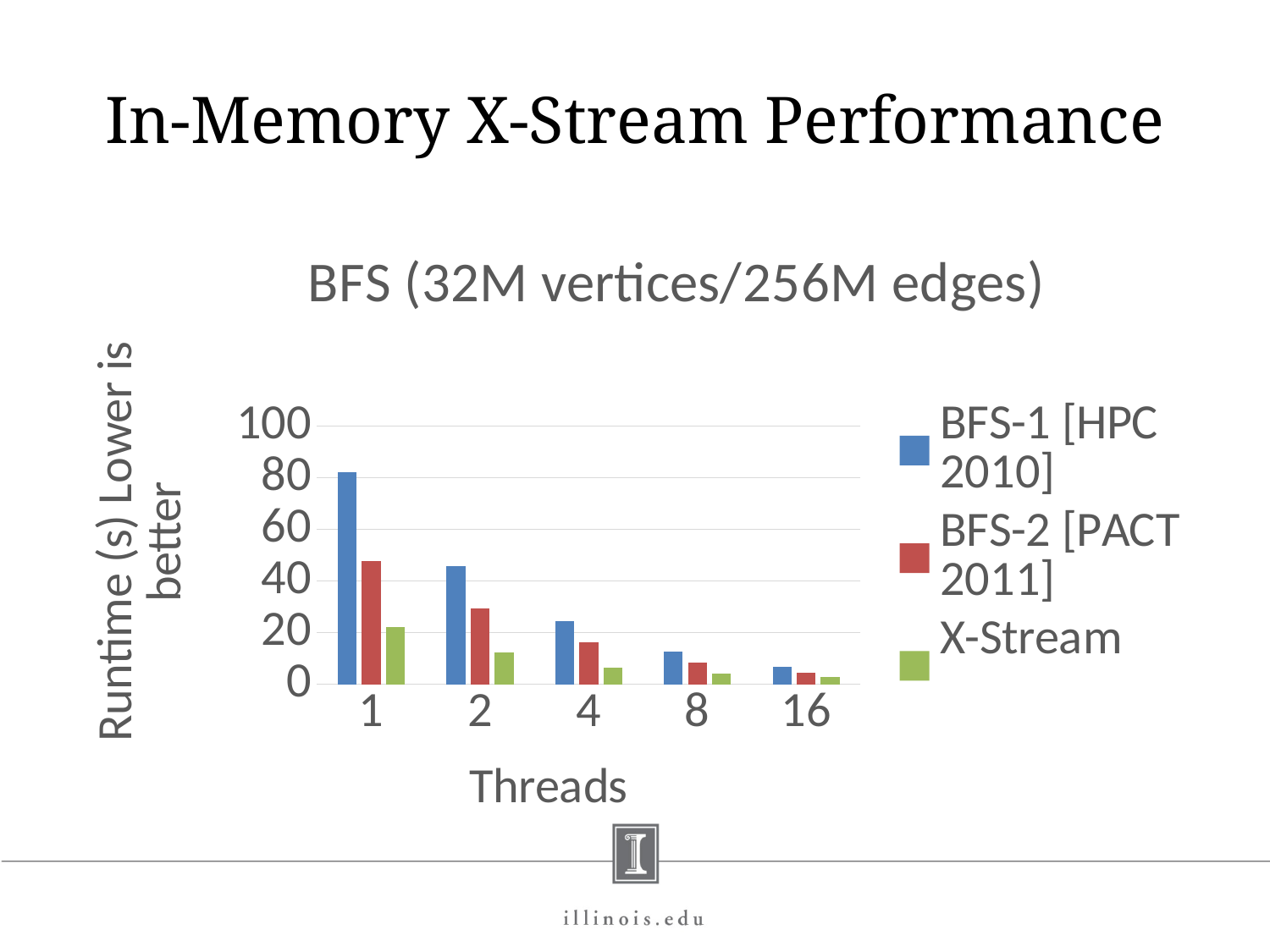
At which thread count is the BFS-1 [HPC 2010] runtime highest? 1 How does the BFS-1 [HPC 2010] runtime change as the number of threads increases? It falls Is the runtime for X-Stream at 2 threads greater or less than 20? less What is the title of the chart? BFS (32M vertices/256M edges) How many series does the legend list? 3 What is the label of the x axis? Threads Is the runtime for BFS-1 [HPC 2010] at 1 thread greater or less than 60? greater How many thread counts are shown on the x axis? 5 What kind of chart is shown on the slide? bar chart Is the runtime for BFS-2 [PACT 2011] at 1 thread greater or less than 40? greater Which series has the lowest runtime at 1 thread? X-Stream At 1 thread, which has the larger runtime, BFS-1 [HPC 2010] or X-Stream? BFS-1 [HPC 2010]